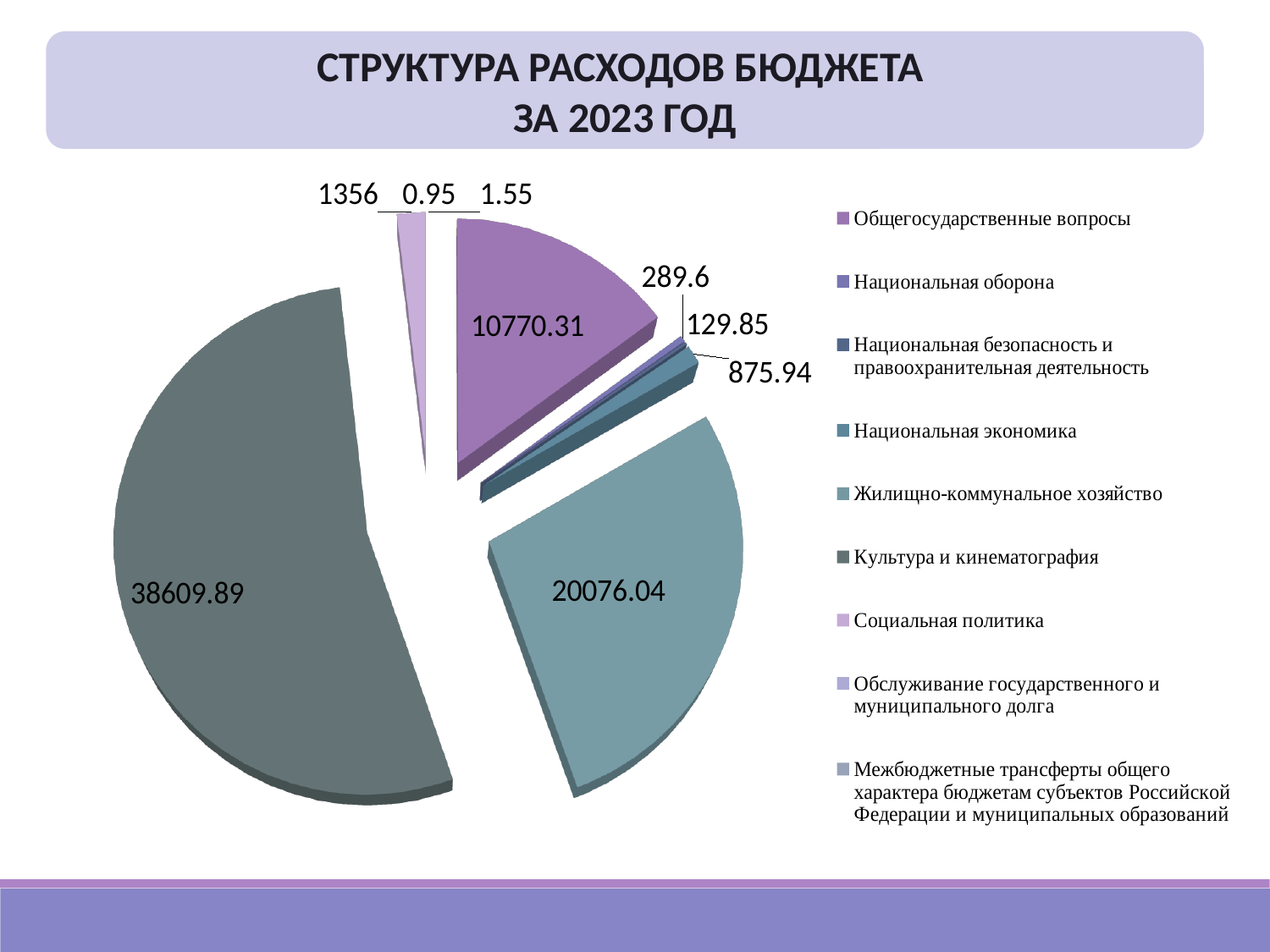
What is the value for Социальная политика? 1356 What is the title of the chart on the slide? СТРУКТУРА РАСХОДОВ БЮДЖЕТА ЗА 2023 ГОД What type of chart is shown on the slide? pie chart What is the value for Жилищно-коммунальное хозяйство? 20076.04 How many categories does the legend list? 9 What is the value for Национальная экономика? 875.94 Which category has the largest slice of the pie? Культура и кинематография What is the difference between the values for Культура и кинематография and Жилищно-коммунальное хозяйство? 18533.85 What is the value for Общегосударственные вопросы? 10770.31 What is the value for Культура и кинематография? 38609.89 Which category has the smallest value? Обслуживание государственного и муниципального долга Which is larger, the value for Национальная оборона or the value for Национальная безопасность и правоохранительная деятельность? Национальная оборона